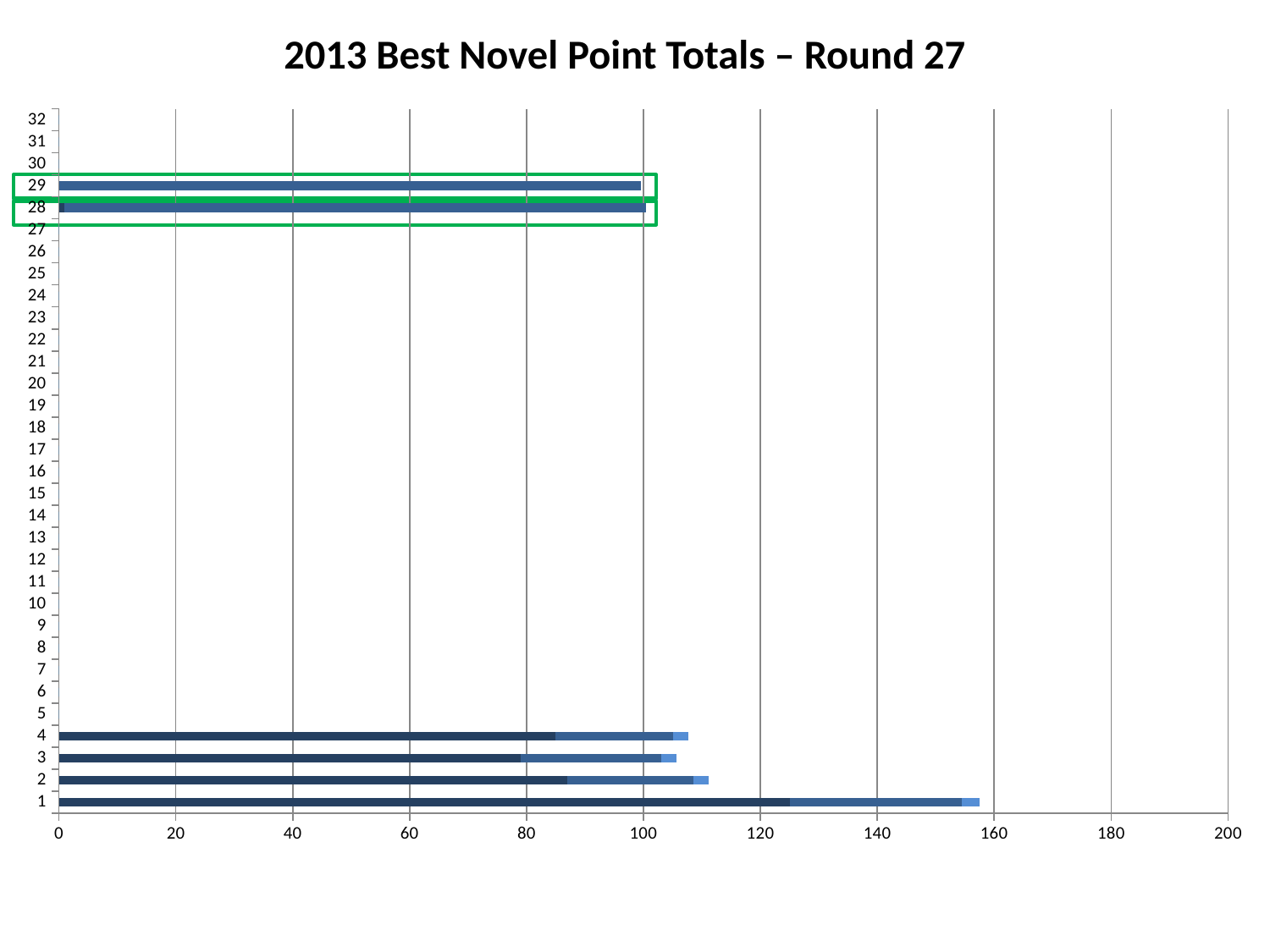
What is the title of the chart? 2013 Best Novel Point Totals – Round 27 Is the value for category 1 greater or less than 140? greater How many categories on the chart have a visible bar? 6 Is the value for category 1 greater or less than 180? less Is the value for category 29 greater or less than 120? less How many categories are listed on the vertical axis of the chart? 32 Which has a larger value, category 1 or category 2? 1 What kind of chart is shown on the slide? bar chart Which category has the highest point total on the chart? 1 Which has a larger value, category 2 or category 29? 2 Which two categories are highlighted with green boxes on the chart? 28 and 29